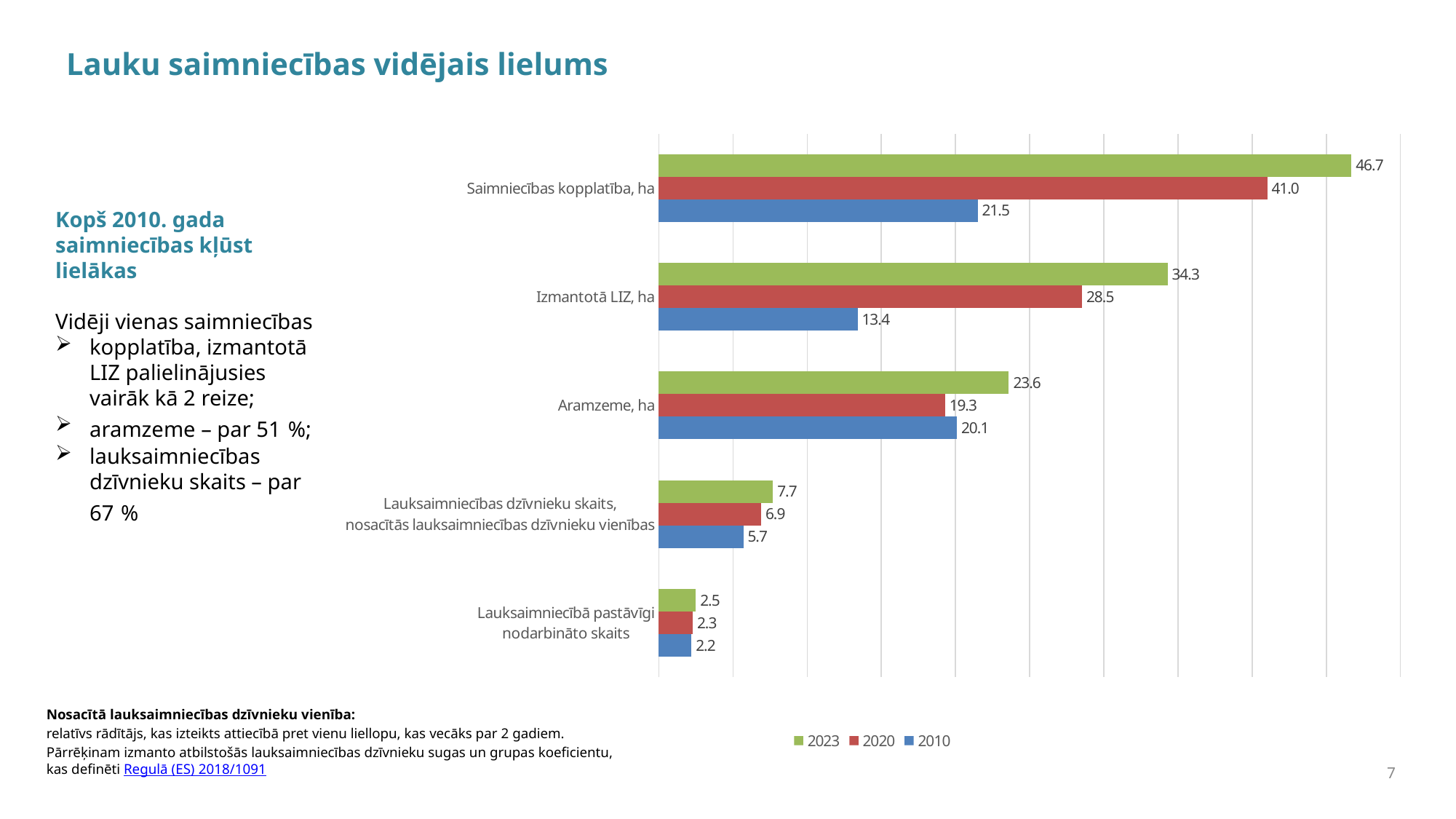
For Aramzeme, ha, which is larger: the 2010 value or the 2020 value? 2010 What is the 2023 value for Lauksaimniecības dzīvnieku skaits, nosacītās lauksaimniecības dzīvnieku vienības? 7.7 How many series does the legend list? 3 How many categories are shown on the chart? 5 What kind of chart is shown on the slide? Bar chart What is the 2010 value for Lauksaimniecībā pastāvīgi nodarbināto skaits? 2.2 What is the difference between the 2023 and 2010 values for Saimniecības kopplatība, ha? 25.2 Which category has the lowest 2010 value? Lauksaimniecībā pastāvīgi nodarbināto skaits What is the value for Saimniecības kopplatība, ha in 2023? 46.7 What is the value for Izmantotā LIZ, ha in 2010? 13.4 What is the value for Aramzeme, ha in 2020? 19.3 Which category has the highest 2023 value? Saimniecības kopplatība, ha